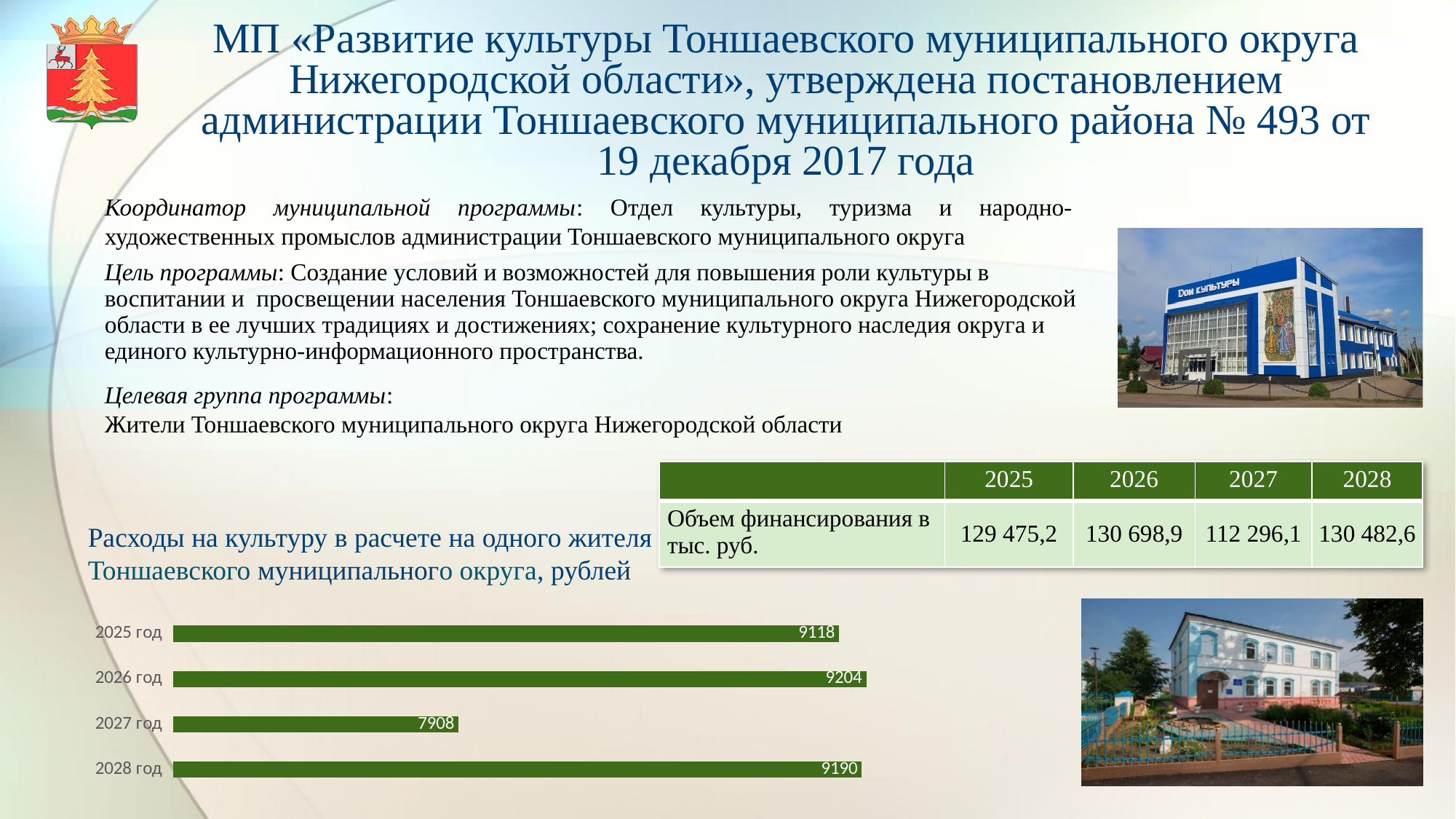
How many years are shown in the chart? 4 What is the value for 2025 год in the chart? 9118 What is the difference between the values for 2026 год and 2027 год? 1296 What is the title of the chart? Расходы на культуру в расчете на одного жителя Тоншаевского муниципального округа, рублей What is the value for 2028 год in the chart? 9190 Which year has the highest value in the chart? 2026 год What is the value for 2026 год in the chart? 9204 What kind of chart is shown on the slide? Bar chart Which is larger, the value for 2025 год or the value for 2027 год? 2025 год Which year has the lowest value in the chart? 2027 год What is the value for 2027 год in the chart? 7908 What is the difference between the values for 2028 год and 2025 год? 72